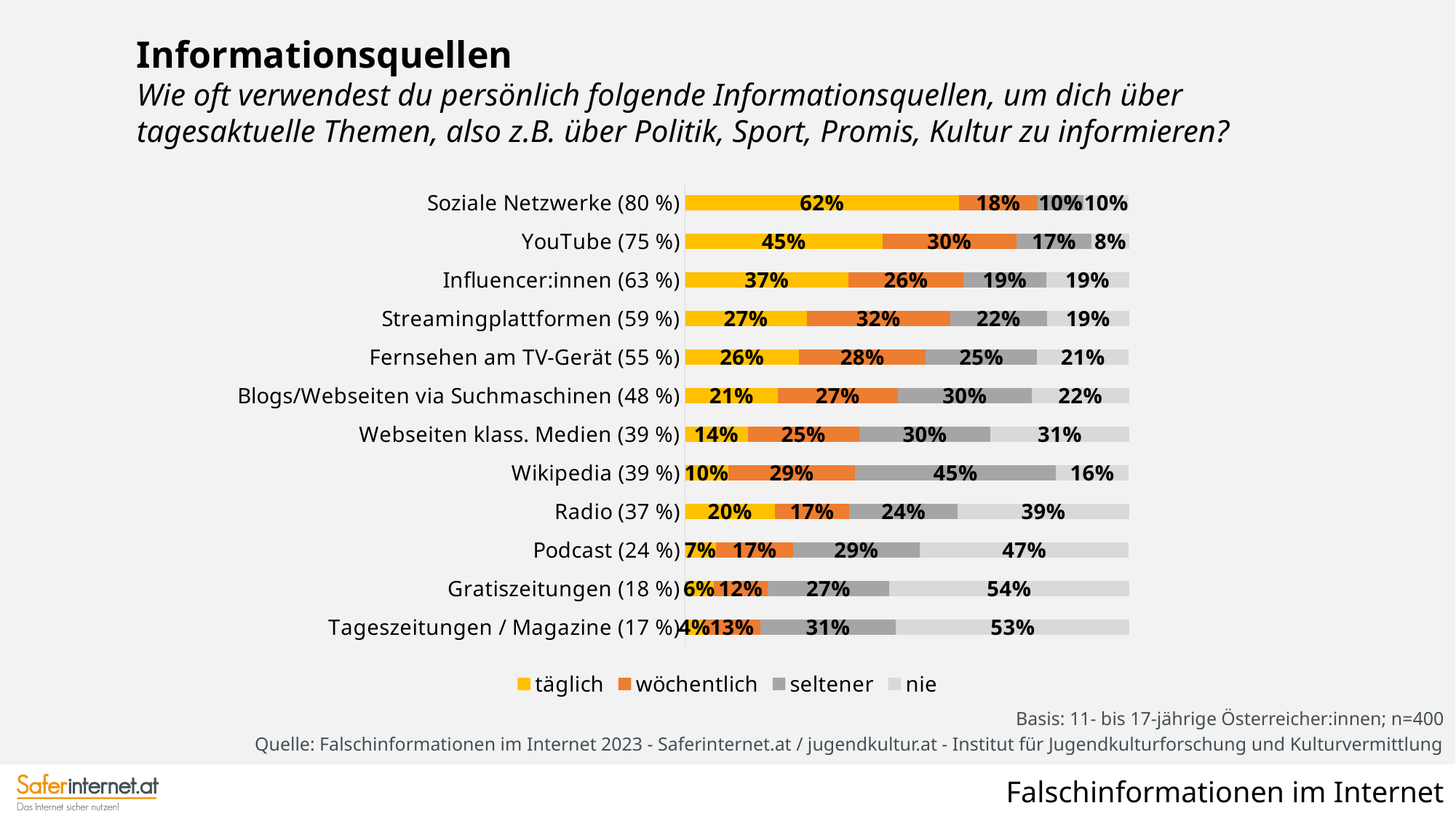
What is the 'seltener' value for Wikipedia? 45% What is the 'täglich' value for Soziale Netzwerke? 62% What is the 'nie' value for Gratiszeitungen? 54% What is the 'wöchentlich' value for Streamingplattformen? 32% Which category has the lowest 'täglich' value? Tageszeitungen / Magazine What is the difference between the 'täglich' values for YouTube and Influencer:innen? 8% How many series does the legend list? 4 What are the four legend entries of the chart? täglich, wöchentlich, seltener, nie Which category has the highest 'täglich' value? Soziale Netzwerke Which is larger: the 'nie' value for Podcast or the 'nie' value for Radio? Podcast How many categories are shown in the chart? 12 What kind of chart is shown on the slide? Stacked bar chart